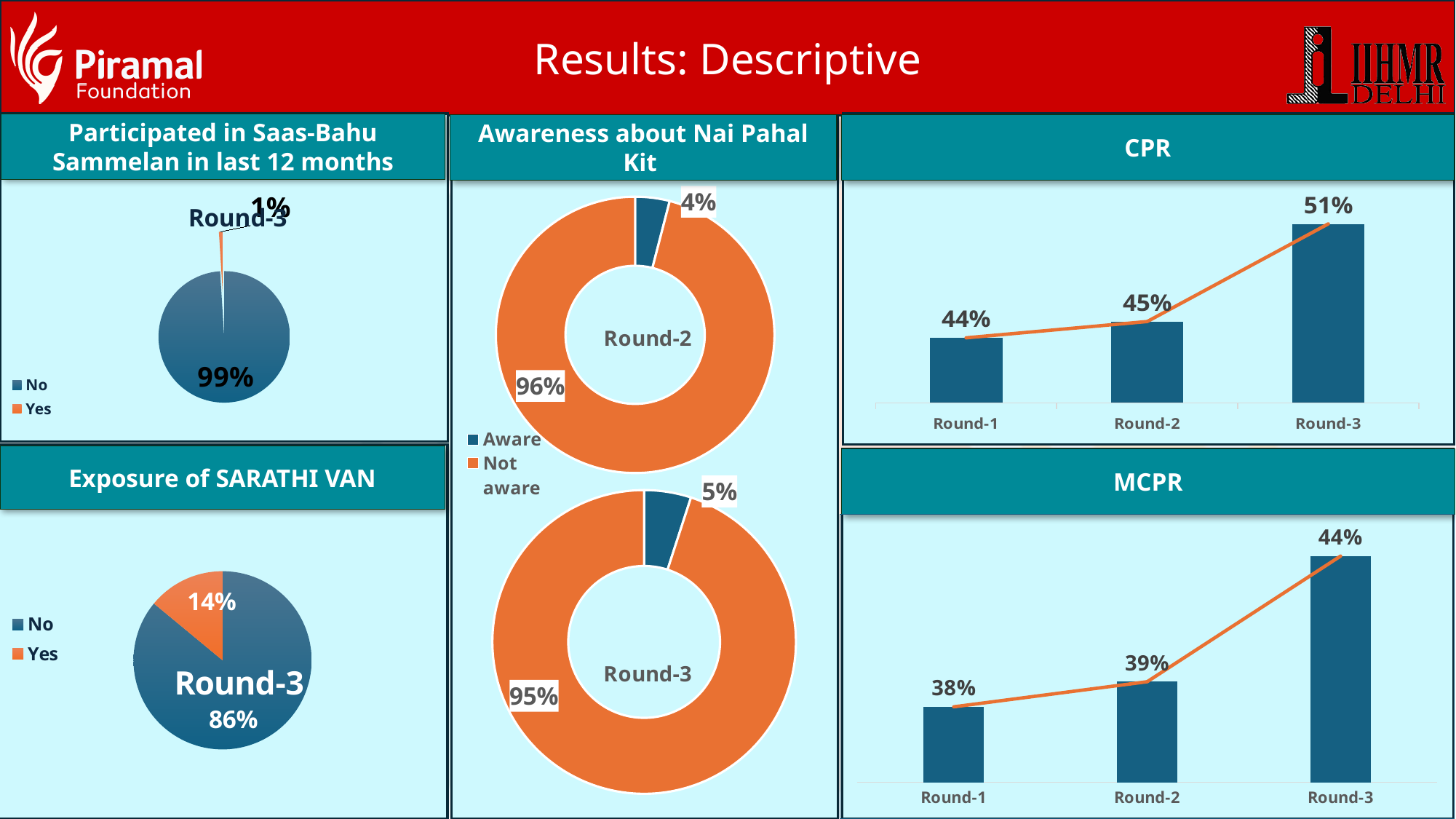
In the Exposure of SARATHI VAN pie chart, what share is Yes? 14% In the CPR chart, which round has the highest value? Round-3 In the MCPR chart, what is the difference between the Round-3 and Round-2 values? 5% In the CPR chart, what is the difference between the Round-3 and Round-1 values? 7% How many rounds are shown in the CPR chart? 3 In the CPR chart, what is the value for Round-3? 51% In the Participated in Saas-Bahu Sammelan in last 12 months chart, what share is No? 99% What kind of chart is the Exposure of SARATHI VAN chart? pie chart Do the values in the MCPR chart rise or fall from Round-1 to Round-3? rise In the MCPR chart, which round has the lowest value? Round-1 In the Awareness about Nai Pahal Kit chart, what is the Aware share for Round-3? 5% In the MCPR chart, what is the value for Round-1? 38%